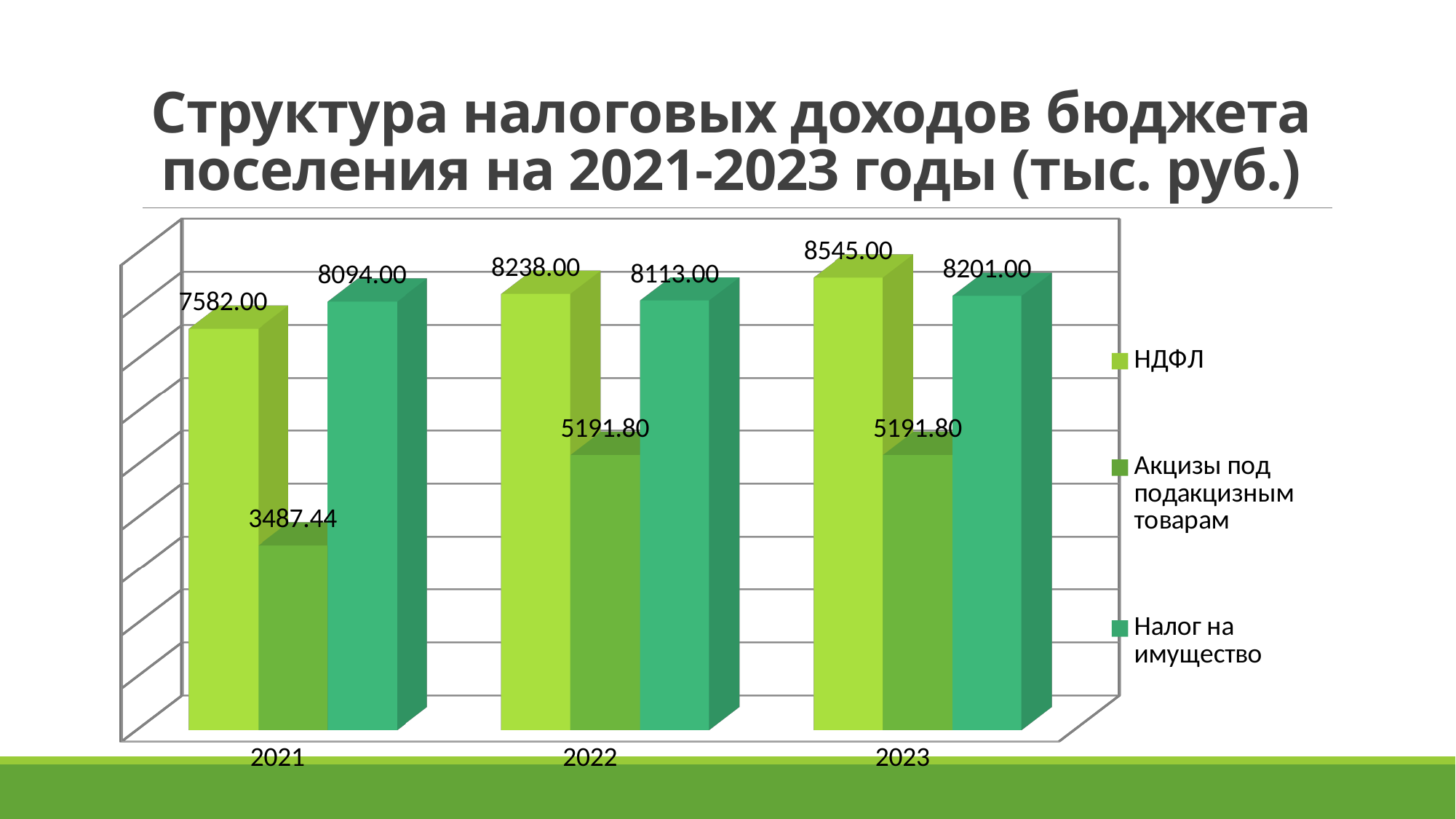
What is the value for Акцизы под подакцизным товарам in 2022? 5191.80 In which year is the НДФЛ value highest? 2023 In which year is the Акцизы под подакцизным товарам value lowest? 2021 What is the value for НДФЛ in 2021? 7582.00 Which is larger in 2021: НДФЛ or Налог на имущество? Налог на имущество How many series does the legend list? 3 How many years are shown on the x axis? 3 Do the НДФЛ values rise or fall from 2021 to 2023? Rise What is the title of the chart? Структура налоговых доходов бюджета поселения на 2021-2023 годы (тыс. руб.) What is the value for Налог на имущество in 2023? 8201.00 What kind of chart is shown on the slide? Bar chart What is the difference between the НДФЛ values for 2023 and 2021? 963.00